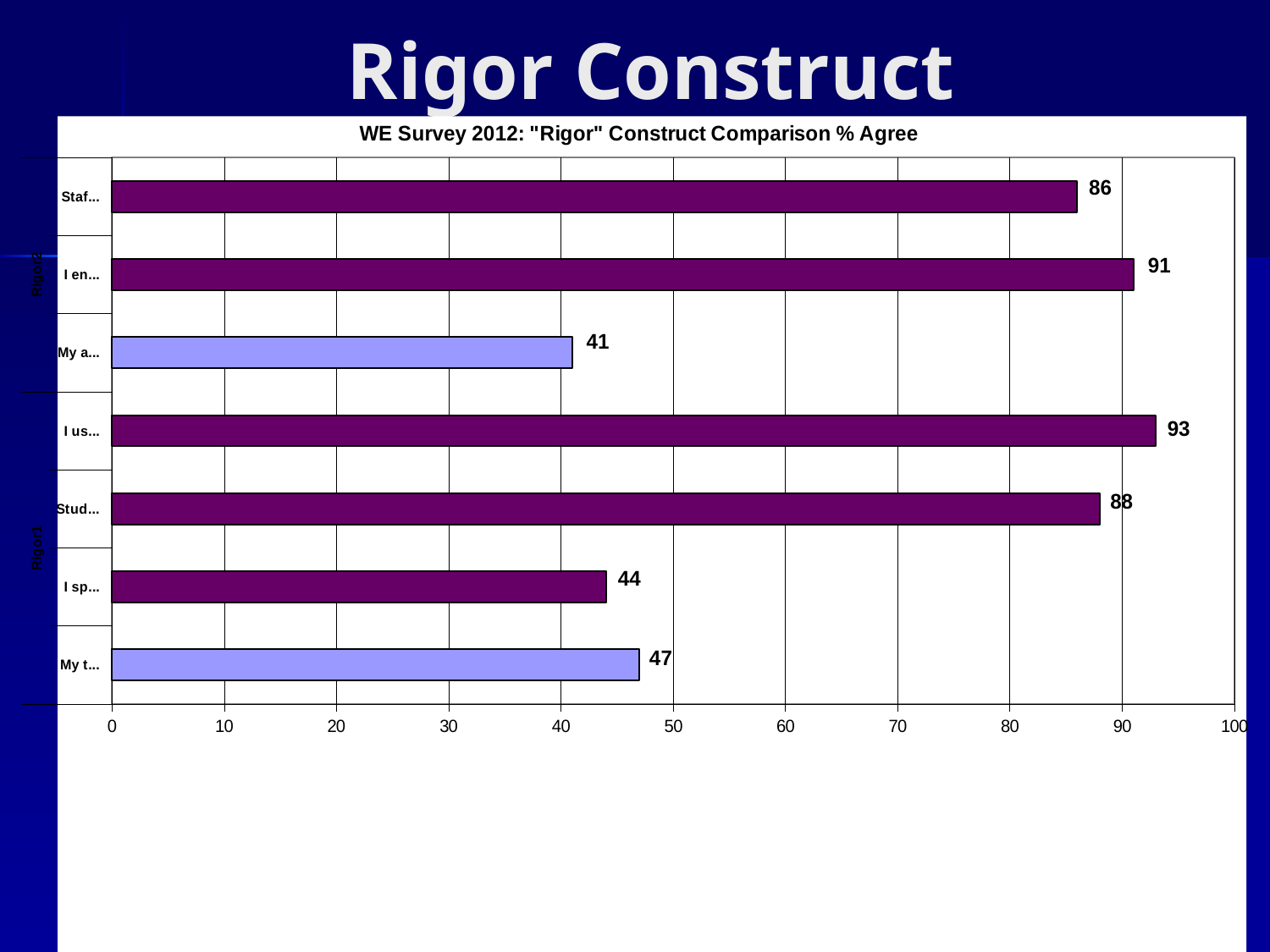
What is the difference between the values for "I en..." and "My a..."? 50 Is the value for "Stud..." greater or less than 80? greater What is the maximum value shown on the horizontal axis? 100 What is the value for the bar labelled "My t..."? 47 Which category has the lowest value? My a... What is the title of the chart? WE Survey 2012: "Rigor" Construct Comparison % Agree Which category has the highest value? I us... What kind of chart is shown on the slide? bar chart What is the value for the bar labelled "Staf..."? 86 What is the value for the bar labelled "I us..."? 93 Which is larger, the value for "I sp..." or the value for "My t..."? My t... How many bars are plotted in the chart? 7